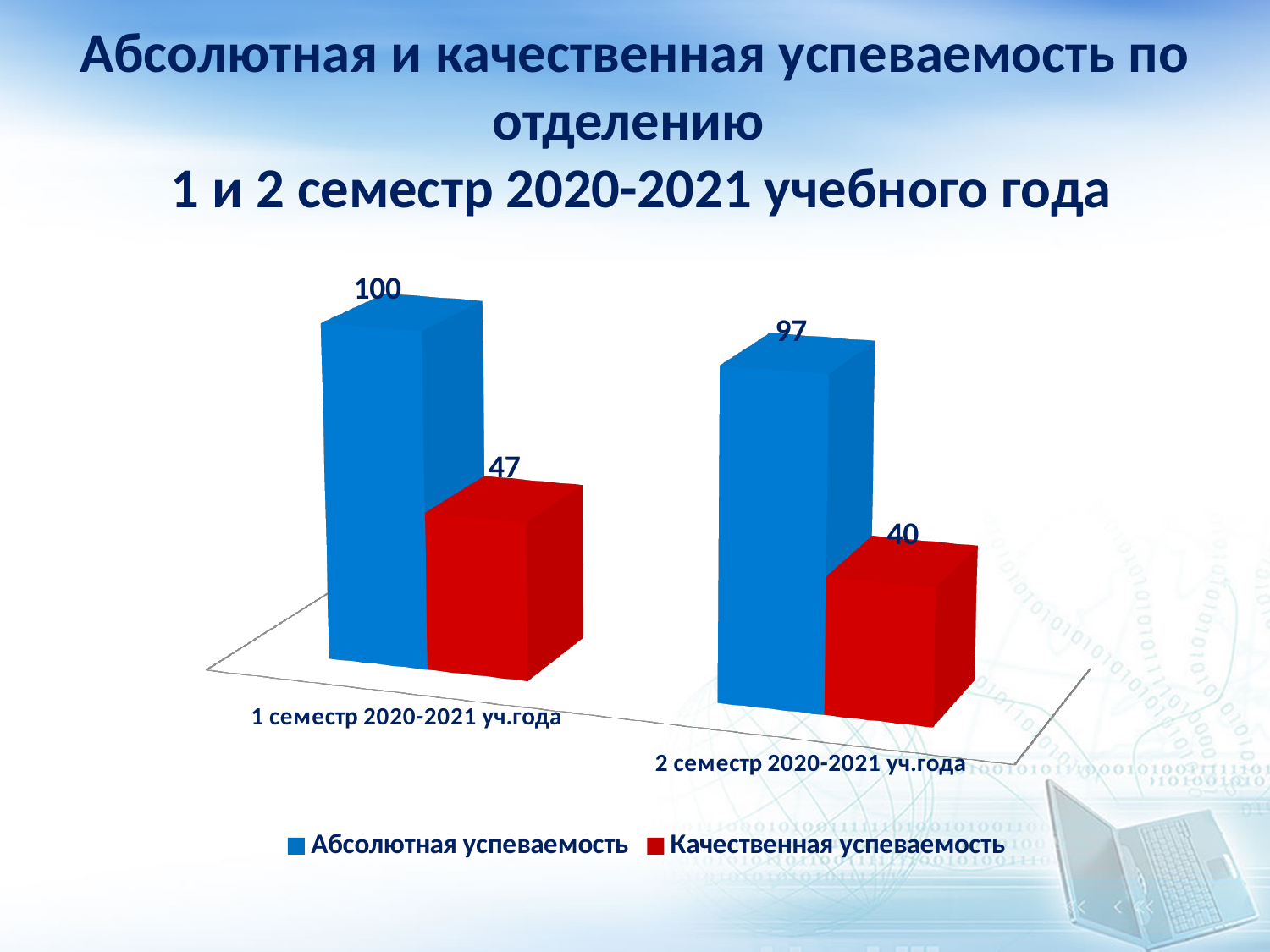
How many series does the legend list? 2 Is Абсолютная успеваемость in 1 семестр 2020-2021 уч.года larger or smaller than in 2 семестр? larger By how much did Качественная успеваемость decrease from 1 семестр to 2 семестр 2020-2021 уч.года? 7 How many categories (semesters) are shown on the x axis? 2 What is the value of Абсолютная успеваемость for 1 семестр 2020-2021 уч.года? 100 Which semester has the lower Абсолютная успеваемость? 2 семестр 2020-2021 уч.года Which semester has the higher Качественная успеваемость? 1 семестр 2020-2021 уч.года What kind of chart is shown on the slide? bar chart What is the value of Качественная успеваемость for 1 семестр 2020-2021 уч.года? 47 What is the value of Качественная успеваемость for 2 семестр 2020-2021 уч.года? 40 What is the value of Абсолютная успеваемость for 2 семестр 2020-2021 уч.года? 97 What is the difference between Абсолютная успеваемость and Качественная успеваемость in 1 семестр 2020-2021 уч.года? 53